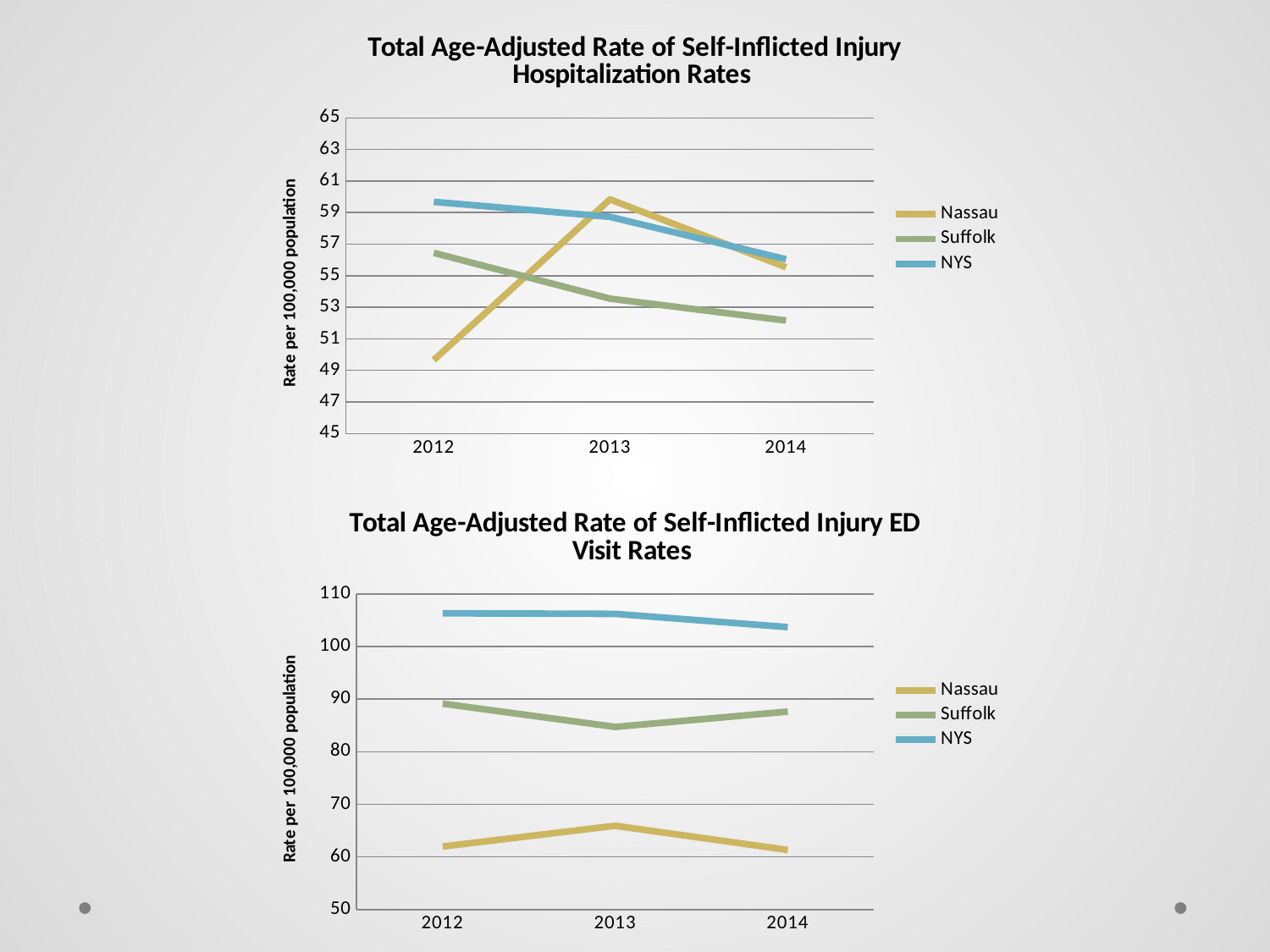
In the Hospitalization Rates chart (top), does the Suffolk line rise or fall from 2012 to 2014? fall In the ED Visit Rates chart (bottom), is the value for Nassau in 2013 greater or less than 70? less In the Hospitalization Rates chart (top), is the value for Nassau in 2012 greater or less than 51? less In the Hospitalization Rates chart (top), how many years are shown on the x axis? 3 In the ED Visit Rates chart (bottom), what is the label on the vertical axis? Rate per 100,000 population In the ED Visit Rates chart (bottom), which series has the highest value in 2013? NYS In the Hospitalization Rates chart (top), which series has the lowest value in 2012? Nassau In the ED Visit Rates chart (bottom), is the value for NYS in 2012 greater or less than 100? greater In the Hospitalization Rates chart (top), which is larger in 2012, Nassau or Suffolk? Suffolk In the Hospitalization Rates chart (top), how many series does the legend list? 3 In the ED Visit Rates chart (bottom), does the NYS line rise or fall from 2012 to 2014? fall In the Hospitalization Rates chart (top), what kind of chart is shown? line chart